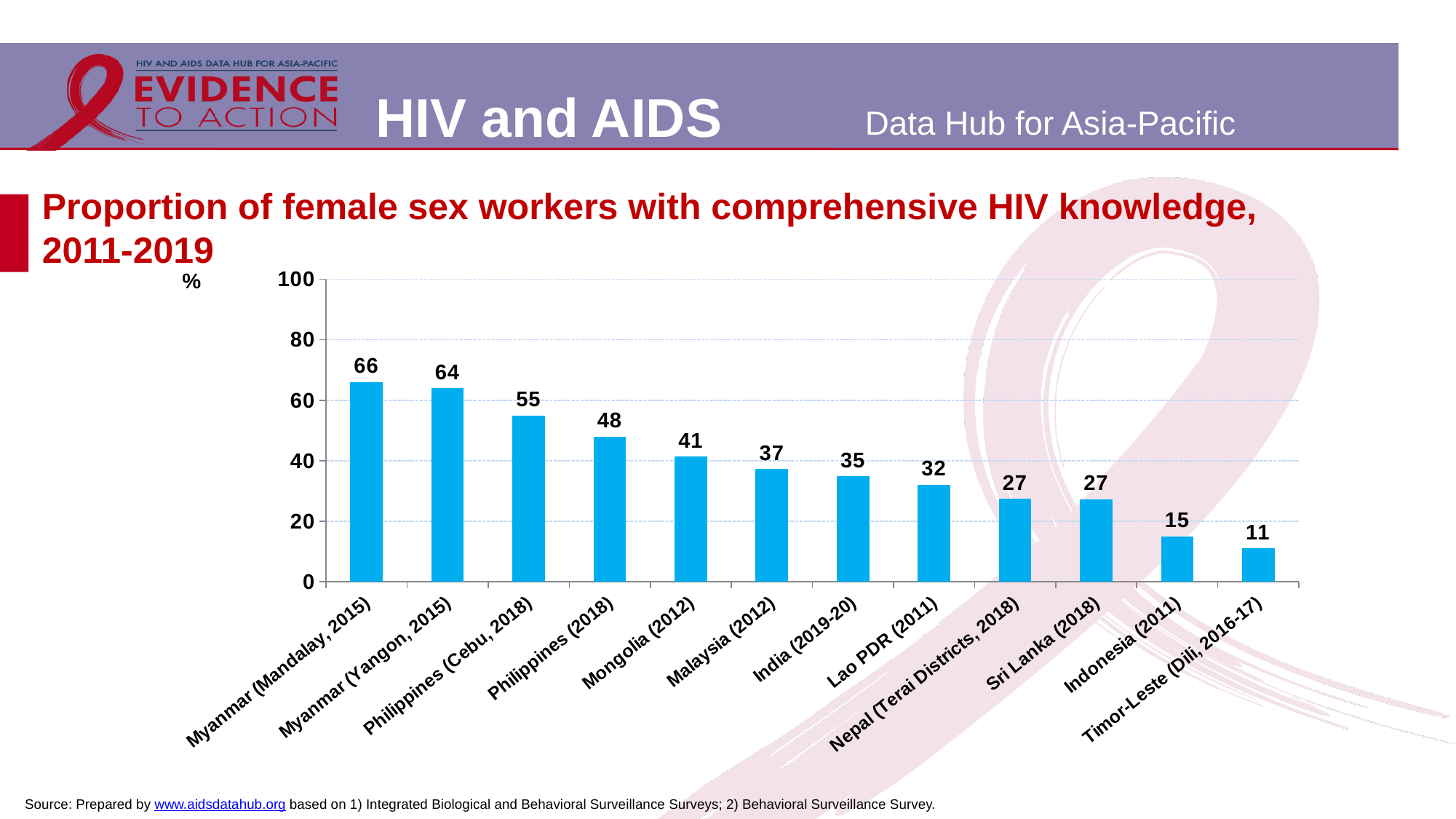
How many categories are shown on the x axis? 12 What kind of chart is shown on the slide? bar chart What is the value for India (2019-20)? 35 What is the value for Myanmar (Mandalay, 2015)? 66 Which category has the lowest value? Timor-Leste (Dili, 2016-17) Is the value for Philippines (2018) greater or less than 40? greater What is the difference between the values for Myanmar (Mandalay, 2015) and Myanmar (Yangon, 2015)? 2 Which category has the highest value? Myanmar (Mandalay, 2015) What is the value for Timor-Leste (Dili, 2016-17)? 11 What is the value for Philippines (Cebu, 2018)? 55 Which is larger, the value for Mongolia (2012) or the value for Lao PDR (2011)? Mongolia (2012) Do the values rise or fall from left to right along the x axis? fall